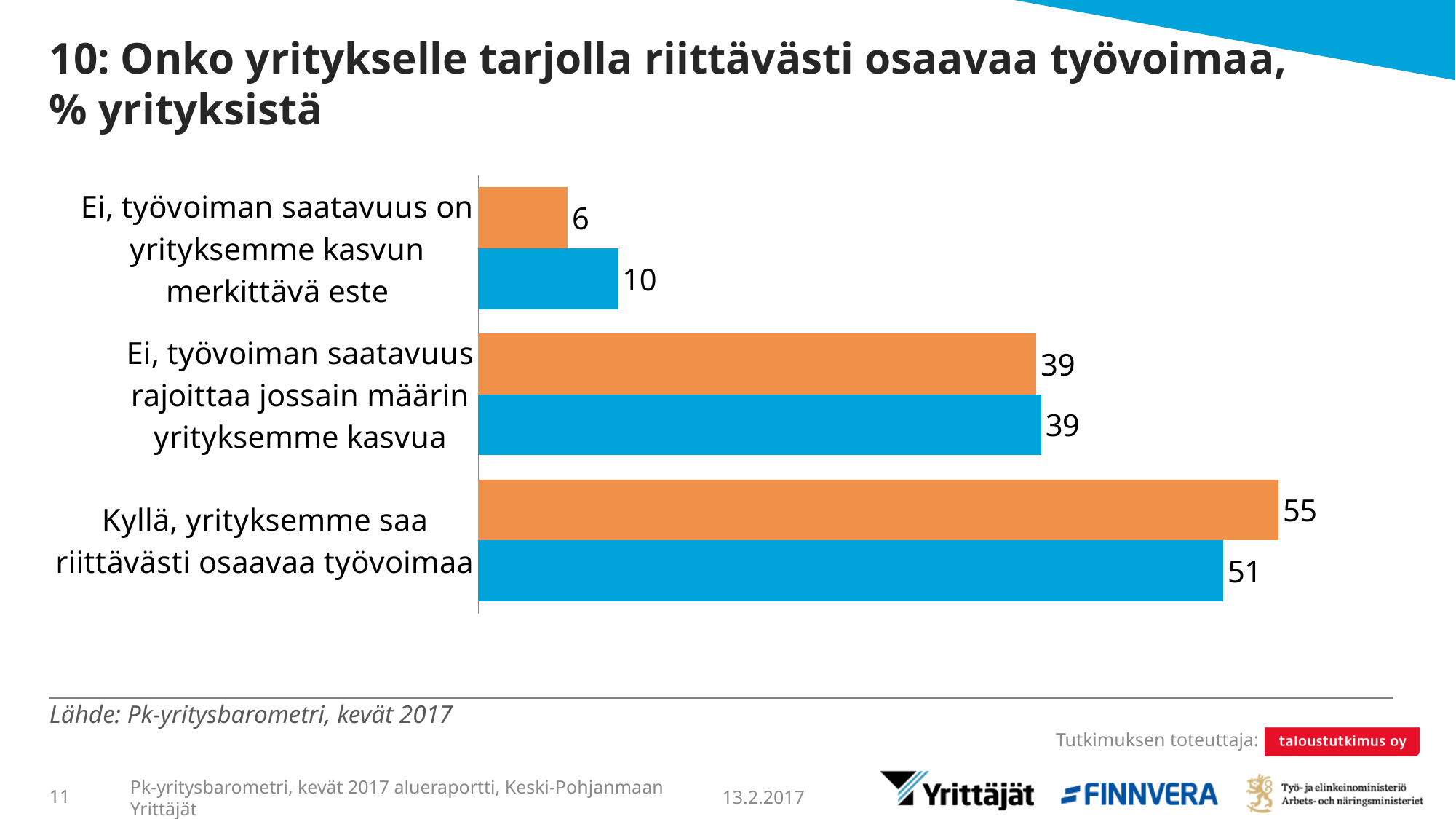
What type of chart is shown on the slide? bar chart For "Ei, työvoiman saatavuus on yrityksemme kasvun merkittävä este", which bar is larger, the orange or the blue one? blue What is the value of the blue bar for "Ei, työvoiman saatavuus on yrityksemme kasvun merkittävä este"? 10 What is the difference between the orange and blue bars for "Kyllä, yrityksemme saa riittävästi osaavaa työvoimaa"? 4 Which category has the highest value among the orange bars? Kyllä, yrityksemme saa riittävästi osaavaa työvoimaa What is the value of the blue bar for "Kyllä, yrityksemme saa riittävästi osaavaa työvoimaa"? 51 What is the value of the orange bar for "Kyllä, yrityksemme saa riittävästi osaavaa työvoimaa"? 55 Which category has the lowest value among the blue bars? Ei, työvoiman saatavuus on yrityksemme kasvun merkittävä este What is the difference between the blue and orange bars for "Ei, työvoiman saatavuus on yrityksemme kasvun merkittävä este"? 4 How many categories are shown on the chart? 3 What is the value of the blue bar for "Ei, työvoiman saatavuus rajoittaa jossain määrin yrityksemme kasvua"? 39 What is the value of the orange bar for "Ei, työvoiman saatavuus on yrityksemme kasvun merkittävä este"? 6